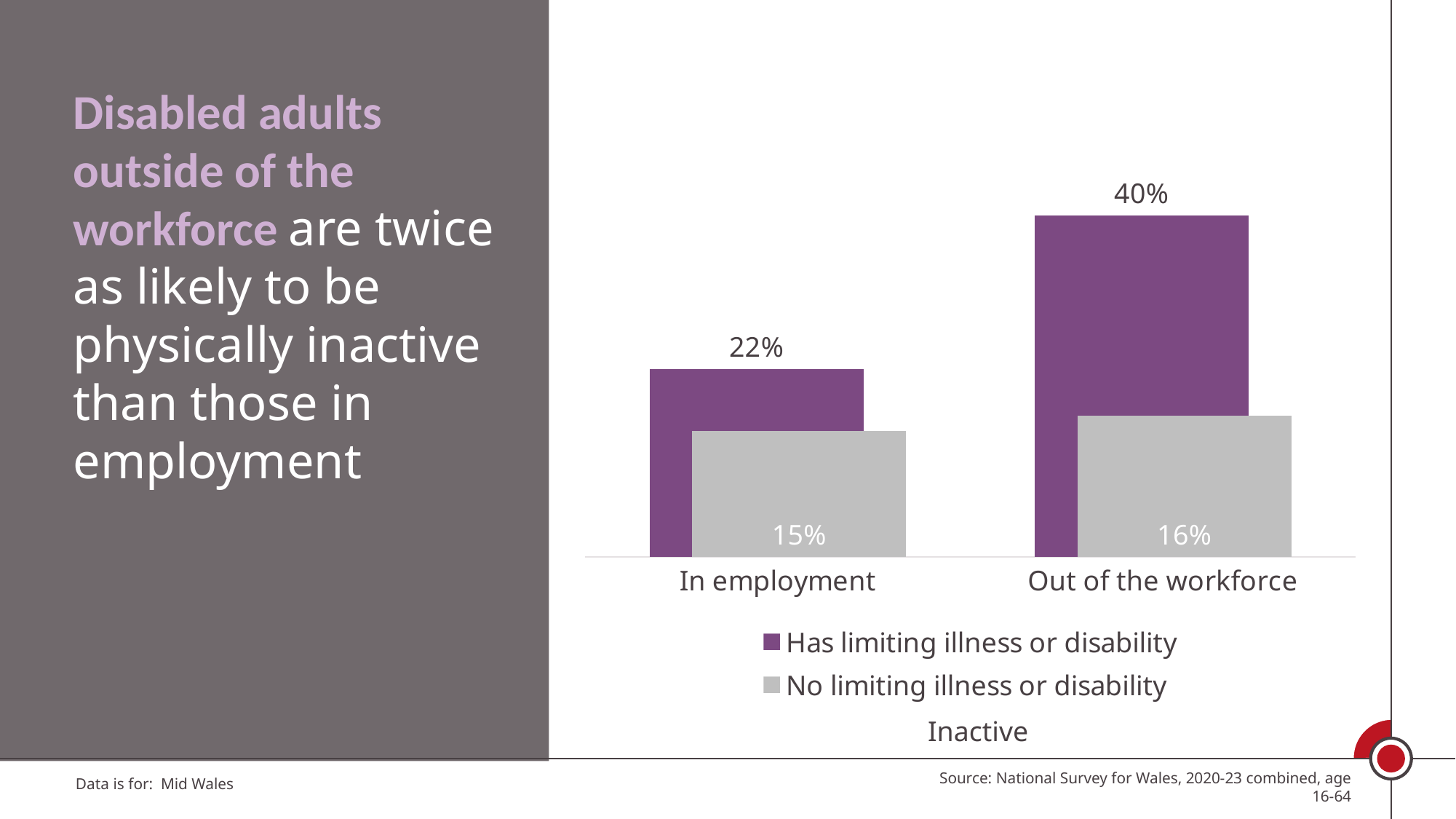
How many series does the legend list? 2 Which category has the lowest value for 'No limiting illness or disability'? In employment What is the value for 'No limiting illness or disability' in the 'In employment' category? 15% What is the value for 'No limiting illness or disability' in the 'Out of the workforce' category? 16% What is the difference between the 'Has limiting illness or disability' values for 'Out of the workforce' and 'In employment'? 18% What is the difference between the two series in the 'Out of the workforce' category? 24% What is the value for 'Has limiting illness or disability' in the 'In employment' category? 22% What kind of chart is shown on the slide? Bar chart Which is larger in the 'In employment' category: 'Has limiting illness or disability' or 'No limiting illness or disability'? Has limiting illness or disability Which category has the highest value for 'Has limiting illness or disability'? Out of the workforce How many categories are shown on the x axis? 2 What is the value for 'Has limiting illness or disability' in the 'Out of the workforce' category? 40%